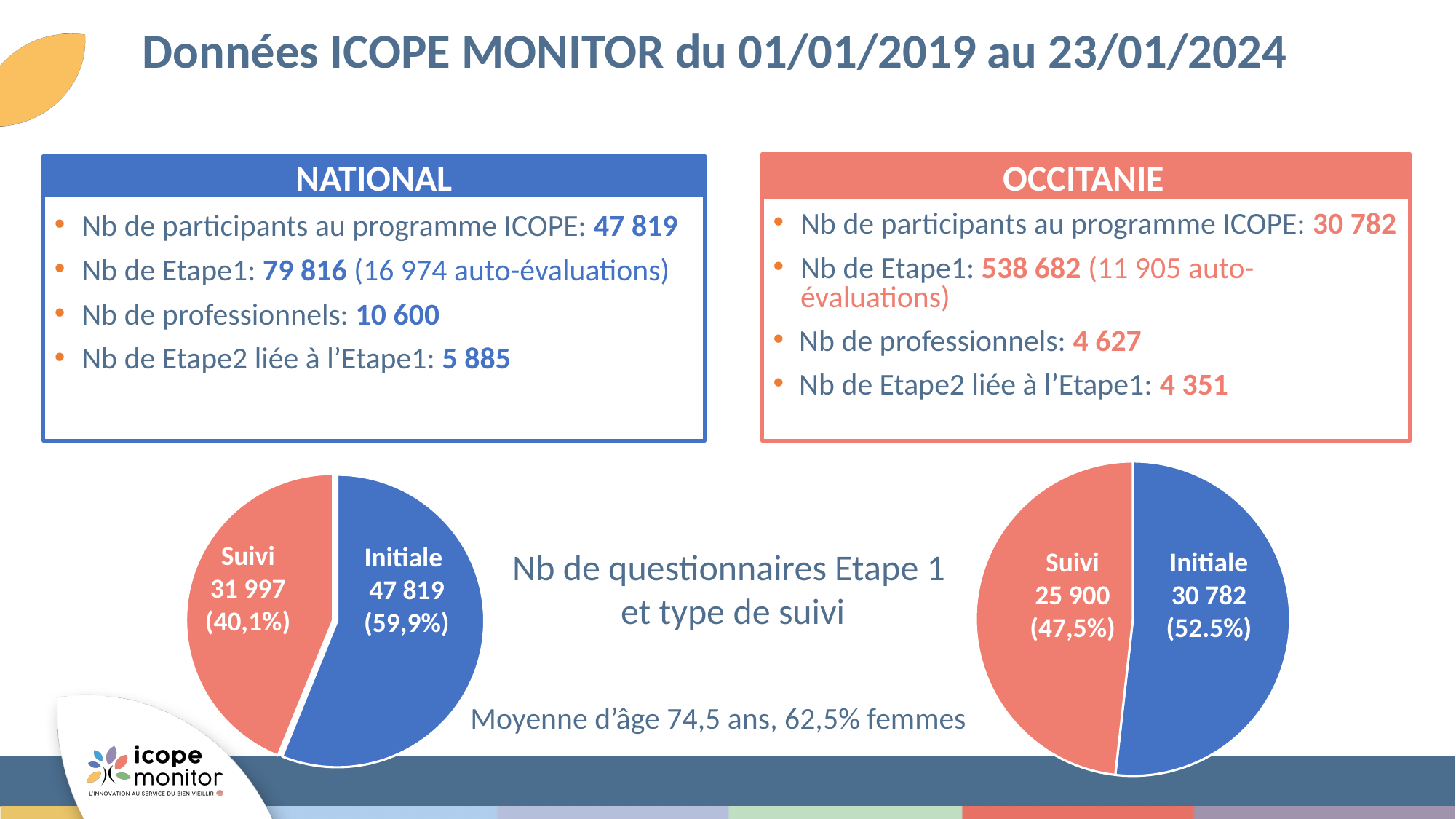
In the left pie chart, what is the difference between the Initiale and Suivi values? 15 822 In the right pie chart, what share of the pie does Suivi represent? 47,5% What title is shown between the two pie charts? Nb de questionnaires Etape 1 et type de suivi In the right pie chart, what is the value for Initiale? 30 782 In the right pie chart, what is the value for Suivi? 25 900 In the left pie chart, what is the value for Suivi? 31 997 In the left pie chart, what is the value for Initiale? 47 819 How many slices does the right pie chart have? 2 In the right pie chart, what is the difference between the Initiale and Suivi values? 4 882 What kind of chart is the left chart on the slide? pie chart In the left pie chart, what share of the pie does Initiale represent? 59,9% In the left pie chart, which slice is larger, Suivi or Initiale? Initiale